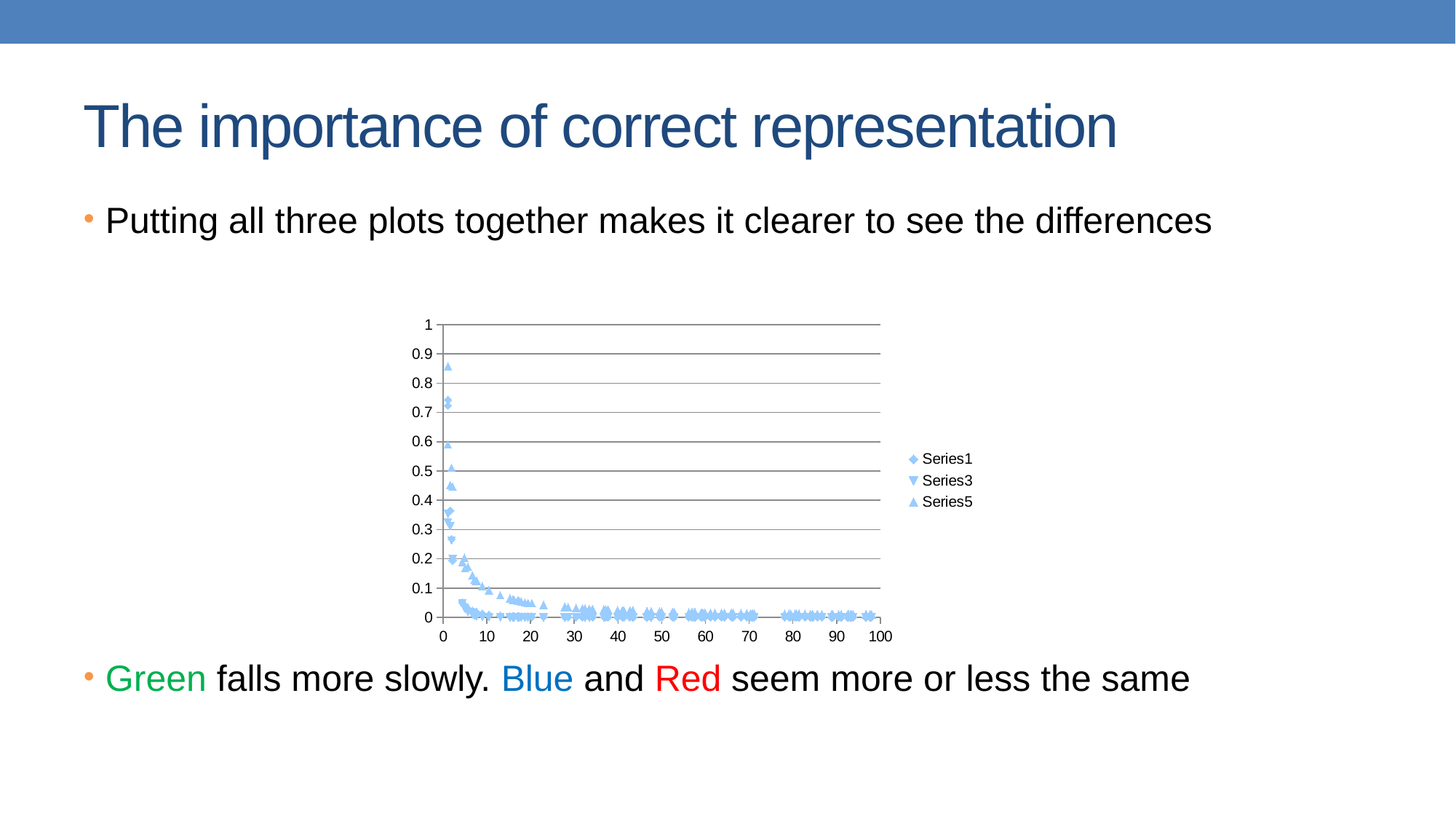
What is the maximum value shown on the chart's y axis? 1 Is the first Series1 point (near x = 1) greater or less than 0.6? greater Which series has the highest plotted value on the chart? Series5 What are the names of the series listed in the chart's legend? Series1, Series3, Series5 Do the plotted values rise or fall as x increases along the x axis? Fall How many series does the chart's legend list? 3 What kind of chart is shown on the slide? Scatter chart Are the Series5 values around x = 20 greater or less than 0.1? less Are the plotted values at x = 50 greater or less than 0.1? less